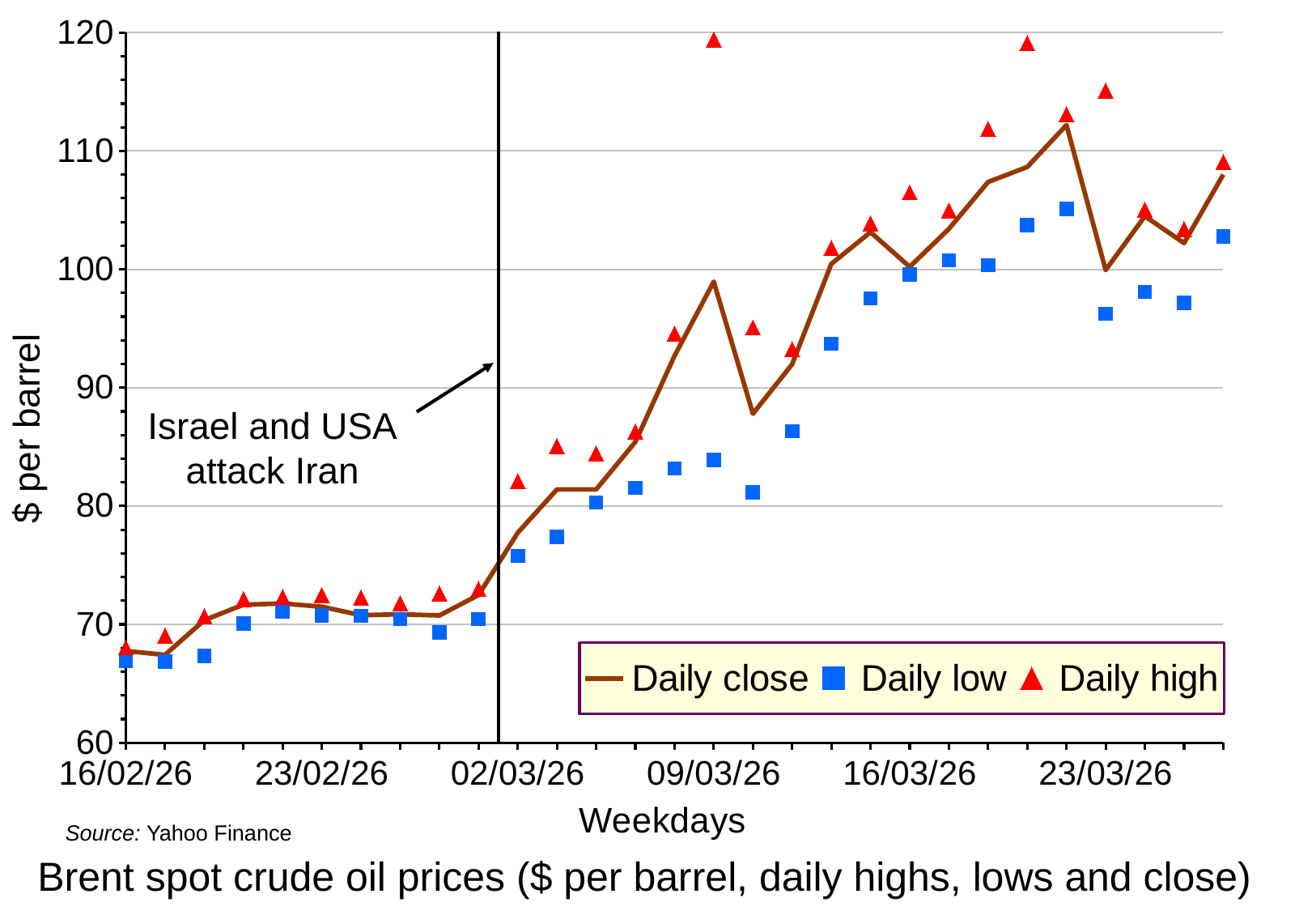
Is the Daily high value on 23/02/26 greater or less than 80? less Is the Daily high value on 09/03/26 greater or less than 110? greater What are the three series named in the legend? Daily close, Daily low, Daily high Which is larger, the Daily close on 16/02/26 or the Daily close on 16/03/26? 16/03/26 How many series does the legend list? 3 Is the Daily close value on 02/03/26 greater or less than 80? less What kind of chart is shown on the slide? line chart What event does the annotation next to the vertical line describe? Israel and USA attack Iran On 09/03/26, which series has the highest value? Daily high Do the Daily close values generally rise or fall from 16/02/26 to the end of the period? rise